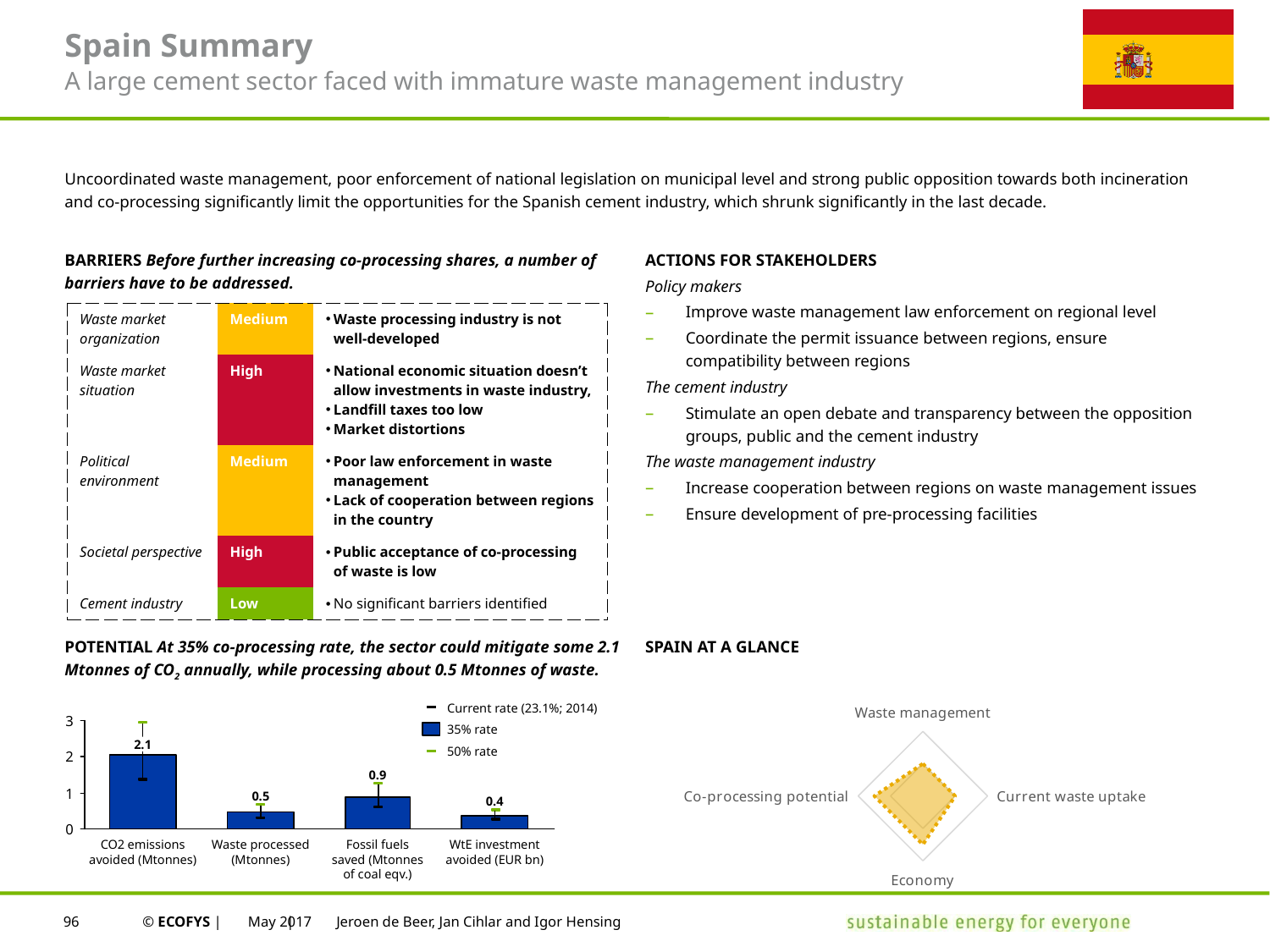
In the bar chart at the bottom left, what is the value for WtE investment avoided (EUR bn) at the 35% rate? 0.4 What kind of chart is shown at the bottom left of the slide? Bar chart In the bar chart at the bottom left, what is the value for Fossil fuels saved (Mtonnes of coal eqv.) at the 35% rate? 0.9 In the bar chart at the bottom left, what is the value for CO2 emissions avoided (Mtonnes) at the 35% rate? 2.1 In the bar chart at the bottom left, which is larger at the 35% rate: Waste processed or Fossil fuels saved? Fossil fuels saved In the bar chart at the bottom left, which category has the lowest 35% rate value? WtE investment avoided (EUR bn) In the bar chart at the bottom left, what is the difference between the 35% rate values for CO2 emissions avoided and Fossil fuels saved? 1.2 In the 'Spain at a glance' chart at the bottom right, how many axes (dimensions) are labelled? 4 In the bar chart at the bottom left, how many categories are shown on the x axis? 4 In the bar chart at the bottom left, how many entries does the legend list? 3 In the bar chart at the bottom left, which category has the highest 35% rate value? CO2 emissions avoided (Mtonnes) In the bar chart at the bottom left, what is the value for Waste processed (Mtonnes) at the 35% rate? 0.5